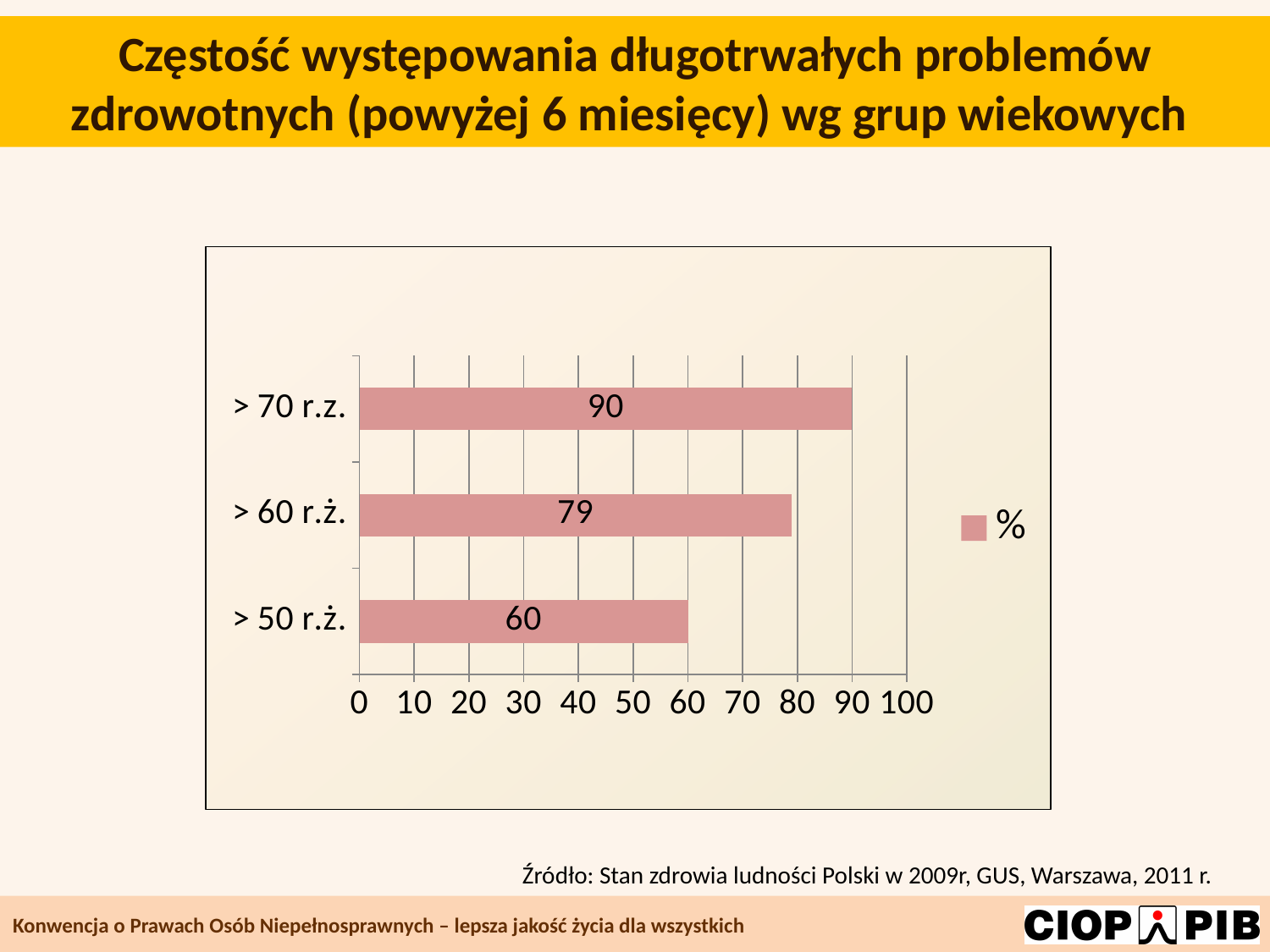
What is the difference between the values for "> 70 r.z." and "> 50 r.ż."? 30 Which age group has the lowest value? > 50 r.ż. Which is larger, the value for "> 60 r.ż." or the value for "> 50 r.ż."? > 60 r.ż. Which age group has the highest value? > 70 r.z. What is the value for the "> 60 r.ż." age group? 79 Is the value for "> 60 r.ż." greater or less than 70? greater What kind of chart is shown on the slide? bar chart What is the legend entry shown in the chart? % How many age groups are shown in the chart? 3 What is the value for the "> 70 r.z." age group? 90 What is the difference between the values for "> 60 r.ż." and "> 50 r.ż."? 19 What is the value for the "> 50 r.ż." age group? 60